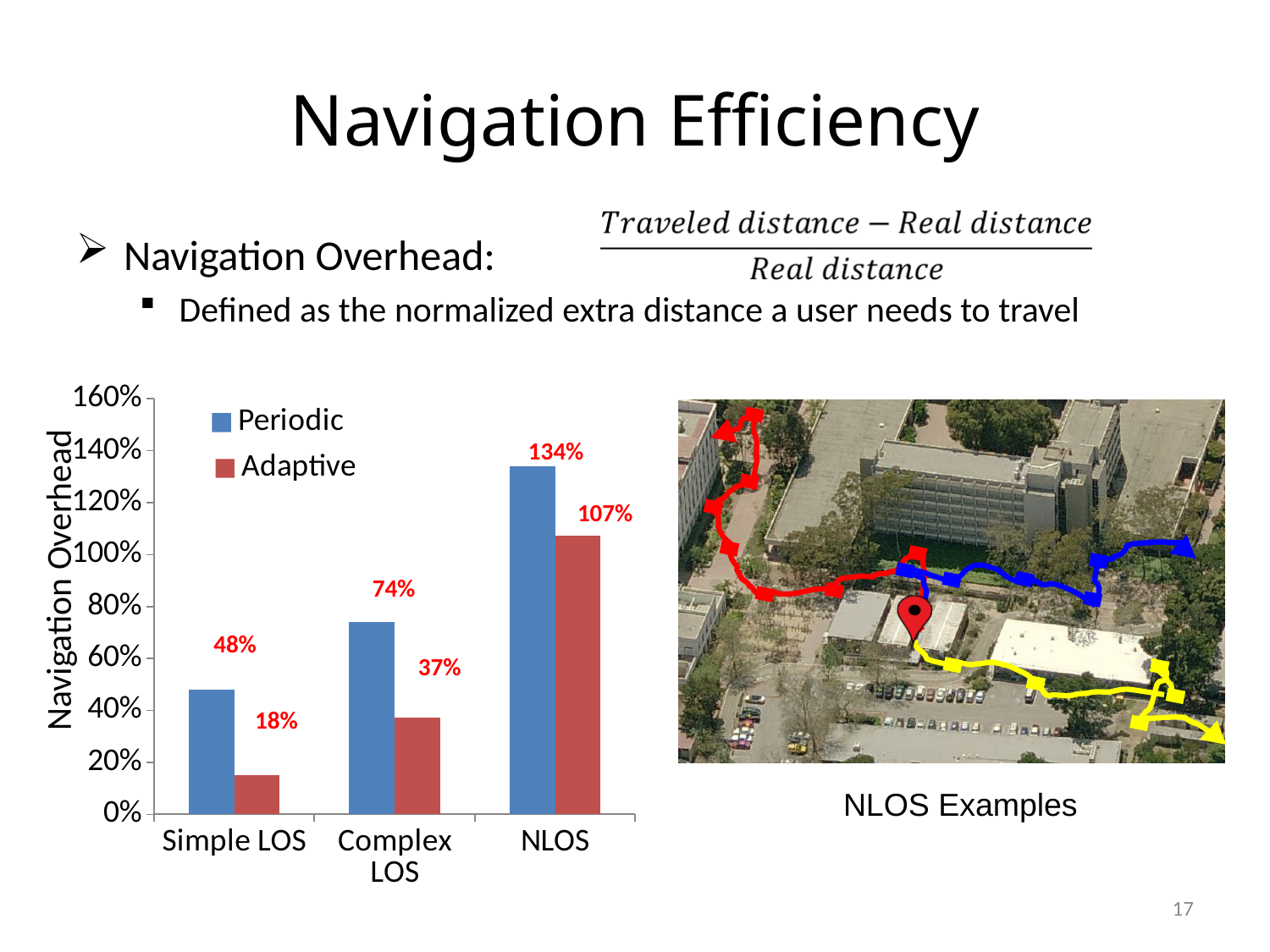
What is the difference between the Periodic and Adaptive navigation overhead for NLOS? 27% What is the Periodic navigation overhead for Simple LOS? 48% Which category has the highest Periodic navigation overhead? NLOS What is the Adaptive navigation overhead for Complex LOS? 37% What is the Adaptive navigation overhead for NLOS? 107% Is the Periodic navigation overhead for NLOS greater or less than 120%? greater What type of chart is used to show navigation overhead? Bar chart How many series does the chart legend list? 2 Which category has the lowest Adaptive navigation overhead? Simple LOS What is the difference between the Periodic and Adaptive navigation overhead for Simple LOS? 30% For Complex LOS, which is larger: the Periodic or the Adaptive navigation overhead? Periodic How many categories are shown on the x axis of the chart? 3